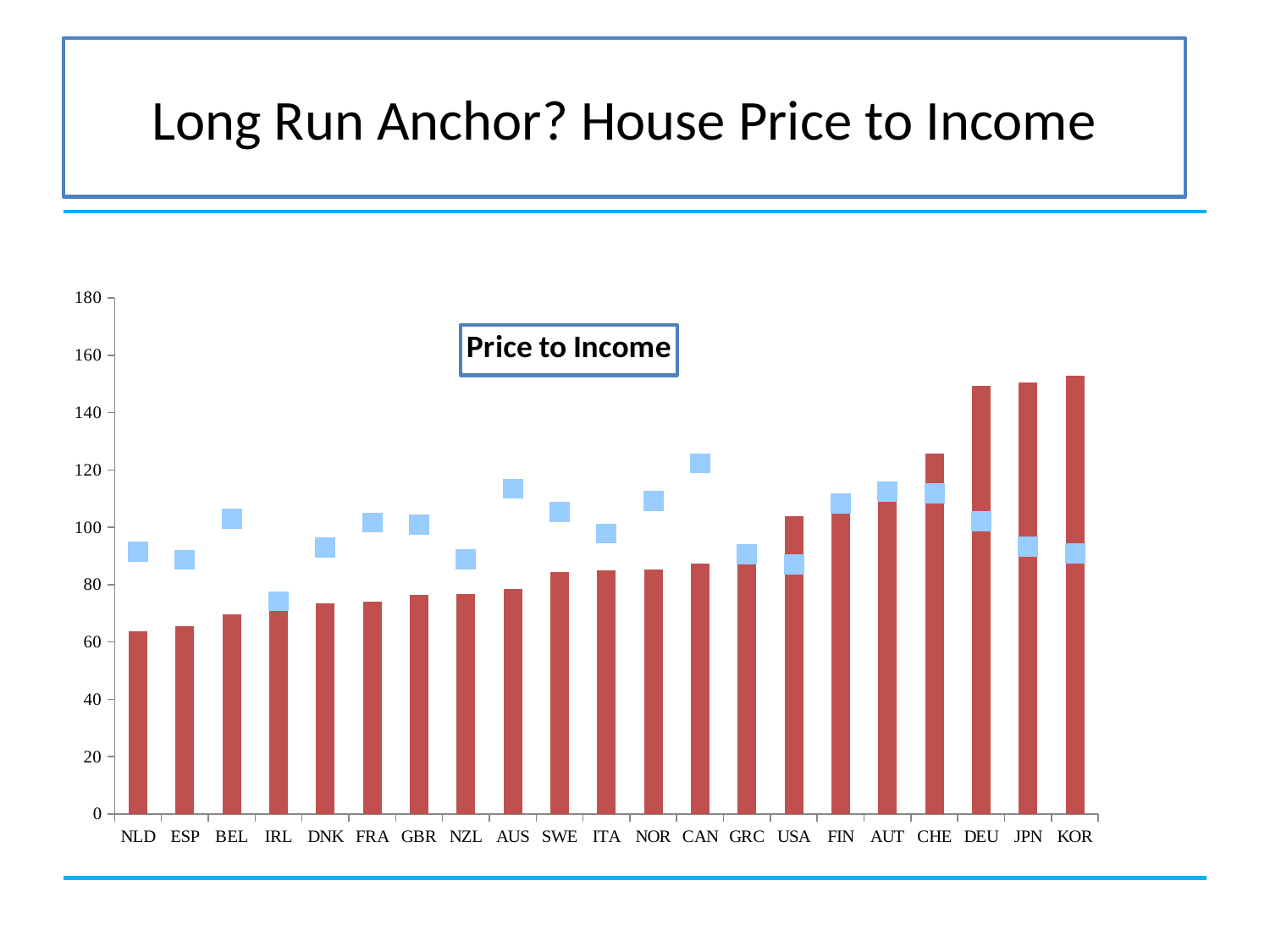
Do the red bars generally rise or fall moving from left to right along the x axis? rise What kind of chart is shown on the slide? bar chart Which country has the lowest blue marker on the chart? IRL Is the blue marker for AUS greater or less than 100? greater Which has the taller red bar, CHE or AUT? CHE Which country has the highest blue marker on the chart? CAN Is the red bar for IRL greater or less than 80? less How many countries are shown on the x axis of the chart? 21 Is the red bar for NLD greater or less than 80? less What is the title shown in the box on the chart? Price to Income